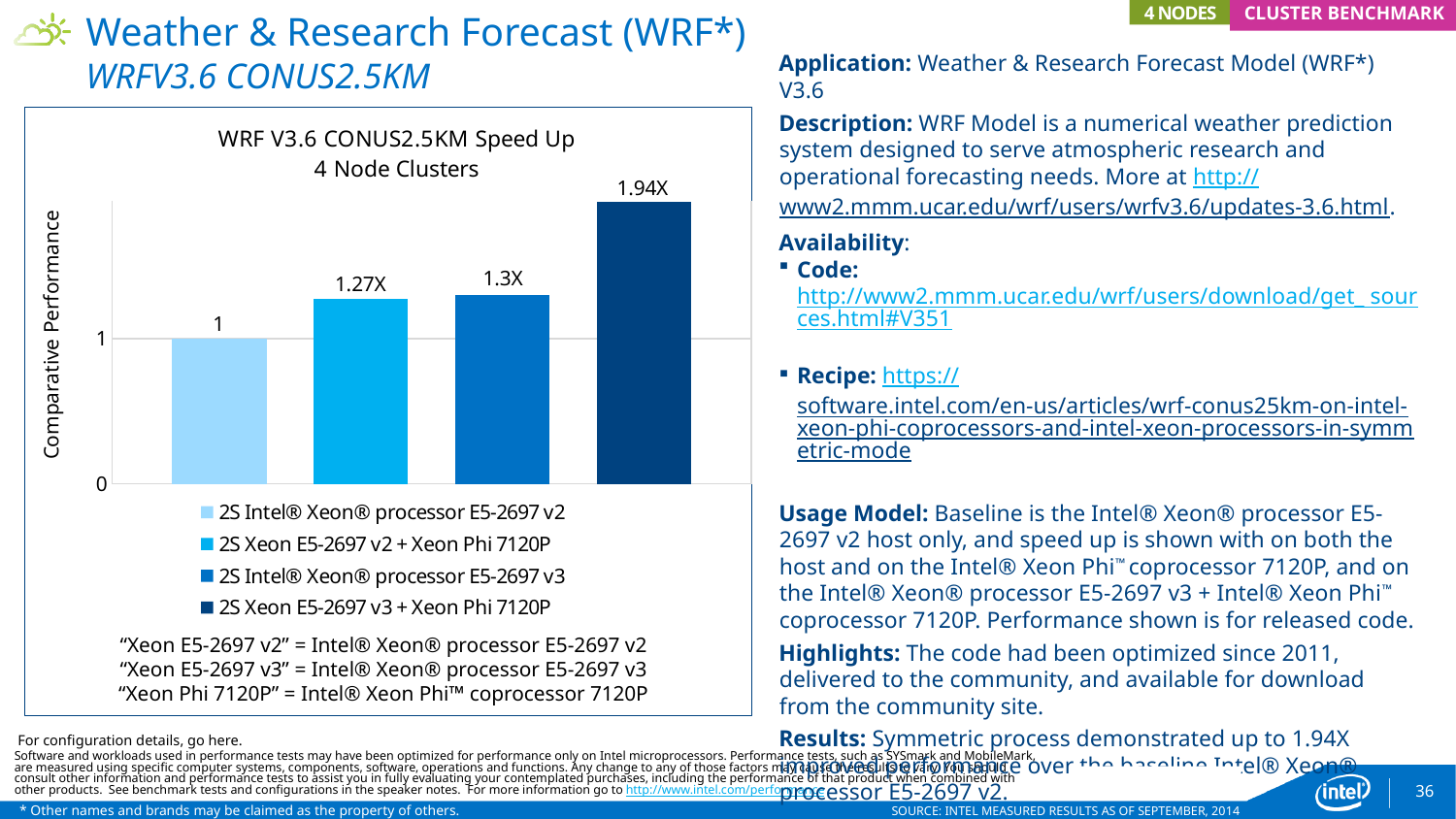
What is the title of the chart? WRF V3.6 CONUS2.5KM Speed Up 4 Node Clusters How many entries does the legend list? 4 Which configuration has the highest comparative performance? 2S Xeon E5-2697 v3 + Xeon Phi 7120P What type of chart is shown on the slide? bar chart How many bars are plotted in the chart? 4 Which is larger, the value for 2S Xeon E5-2697 v3 + Xeon Phi 7120P or the value for 2S Xeon E5-2697 v2 + Xeon Phi 7120P? 2S Xeon E5-2697 v3 + Xeon Phi 7120P What is the value shown for 2S Xeon E5-2697 v2 + Xeon Phi 7120P? 1.27X What is the value shown for 2S Intel® Xeon® processor E5-2697 v2? 1 What is the value shown for 2S Xeon E5-2697 v3 + Xeon Phi 7120P? 1.94X What is the value shown for 2S Intel® Xeon® processor E5-2697 v3? 1.3X Which configuration has the lowest comparative performance? 2S Intel® Xeon® processor E5-2697 v2 What is the label of the vertical axis? Comparative Performance